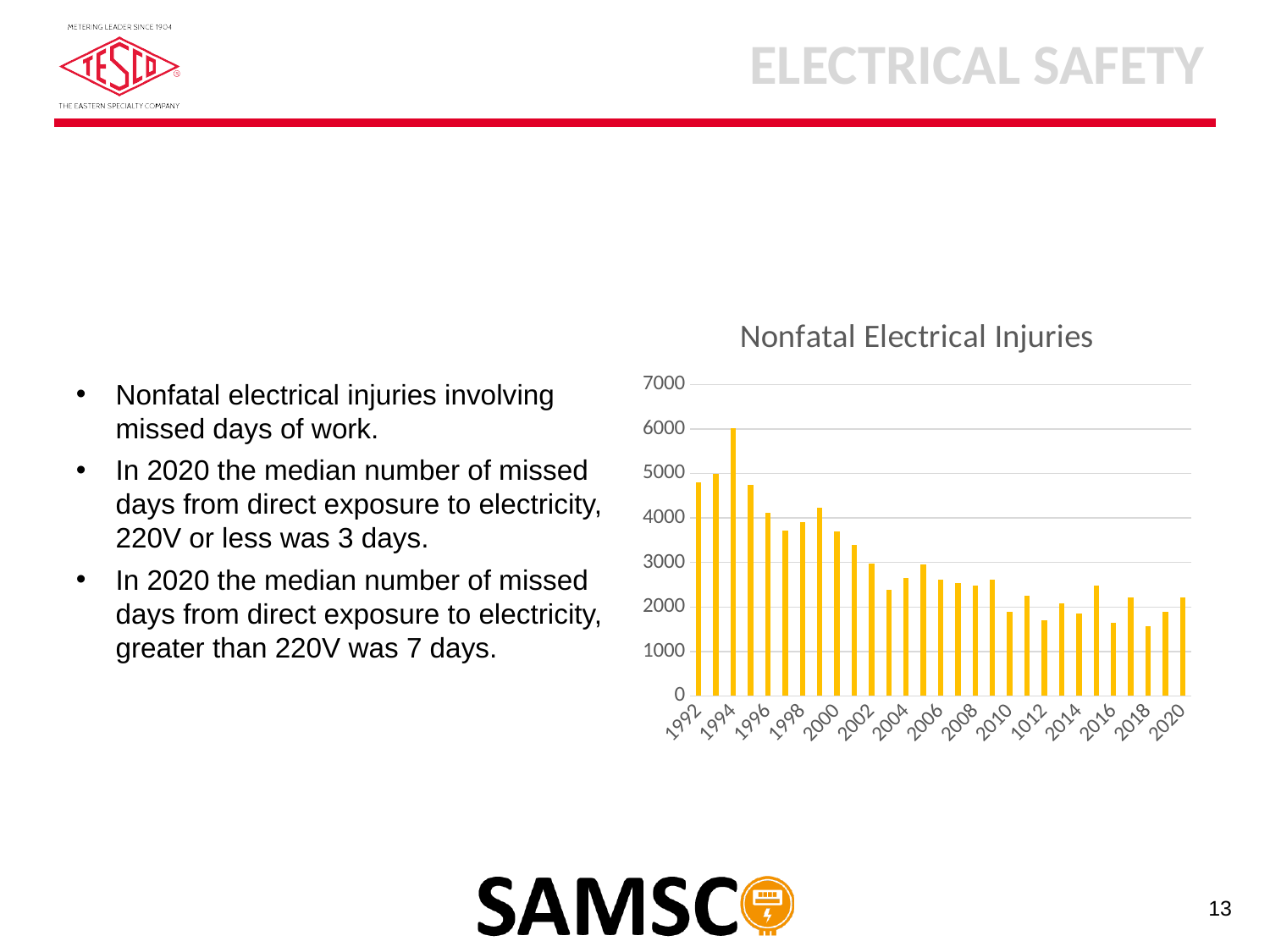
Which year has the larger value, 1994 or 2020? 1994 Is the value for 1994 greater or less than 5000? greater Is the value for 2020 greater or less than 2000? greater What is the title of the chart? Nonfatal Electrical Injuries Is the value for 2018 greater or less than 2000? less Which year has the larger value, 1992 or 2010? 1992 What kind of chart is shown on the slide? Bar chart Overall, do the values rise or fall from 1992 to 2020? Fall What colour are the bars in the chart? Yellow Which year has the highest number of nonfatal electrical injuries? 1994